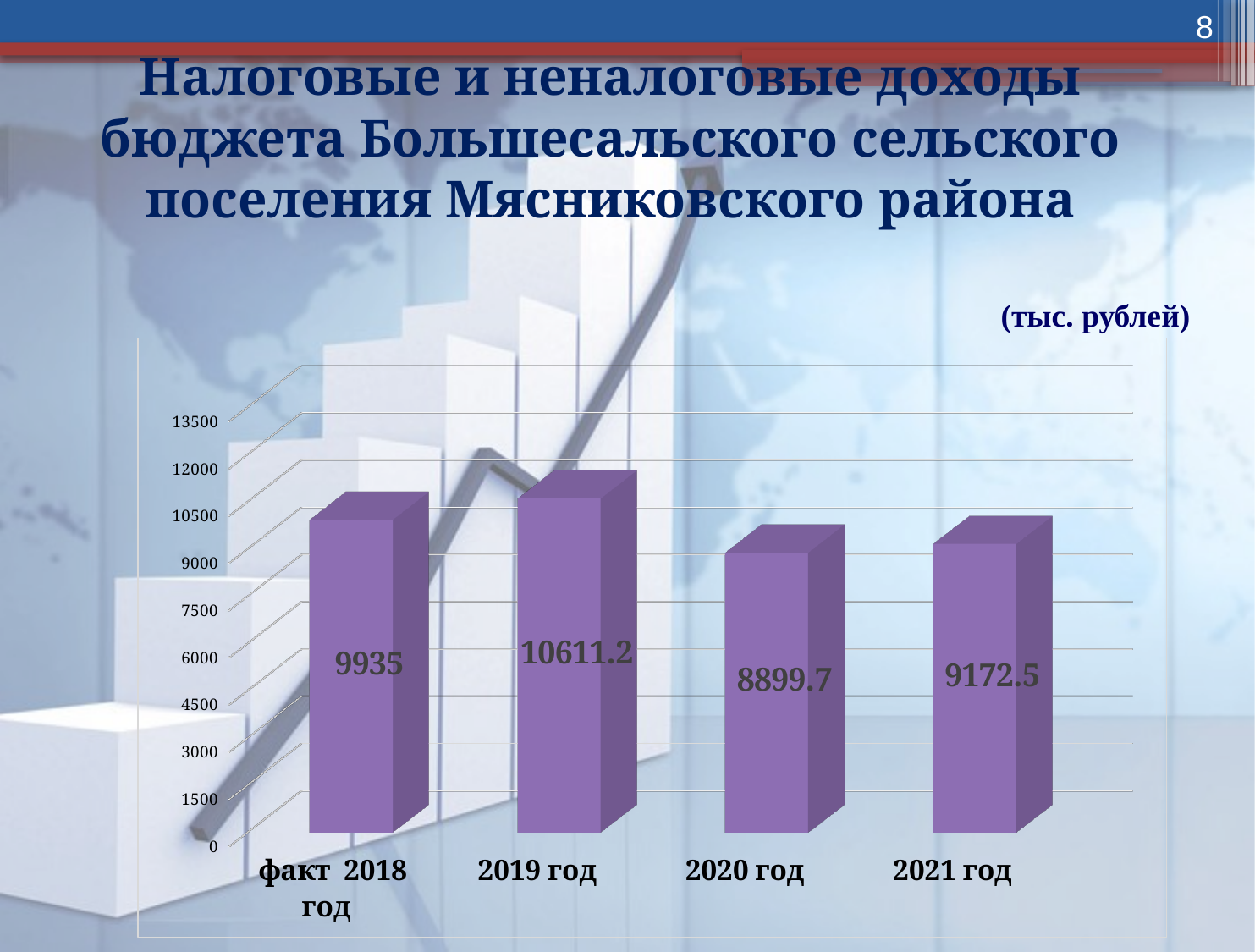
What is the value for факт 2018 год? 9935 What is the value for 2019 год? 10611.2 What is the value for 2021 год? 9172.5 What kind of chart is shown on the slide? bar chart Which year has the highest value? 2019 год Which year has the lowest value? 2020 год What is the difference between the values for 2019 год and факт 2018 год? 676.2 How many bars are shown in the chart? 4 Is the value for факт 2018 год greater or less than 9000? greater Which is larger, the value for факт 2018 год or the value for 2021 год? факт 2018 год What is the value for 2020 год? 8899.7 What is the difference between the values for 2021 год and 2020 год? 272.8